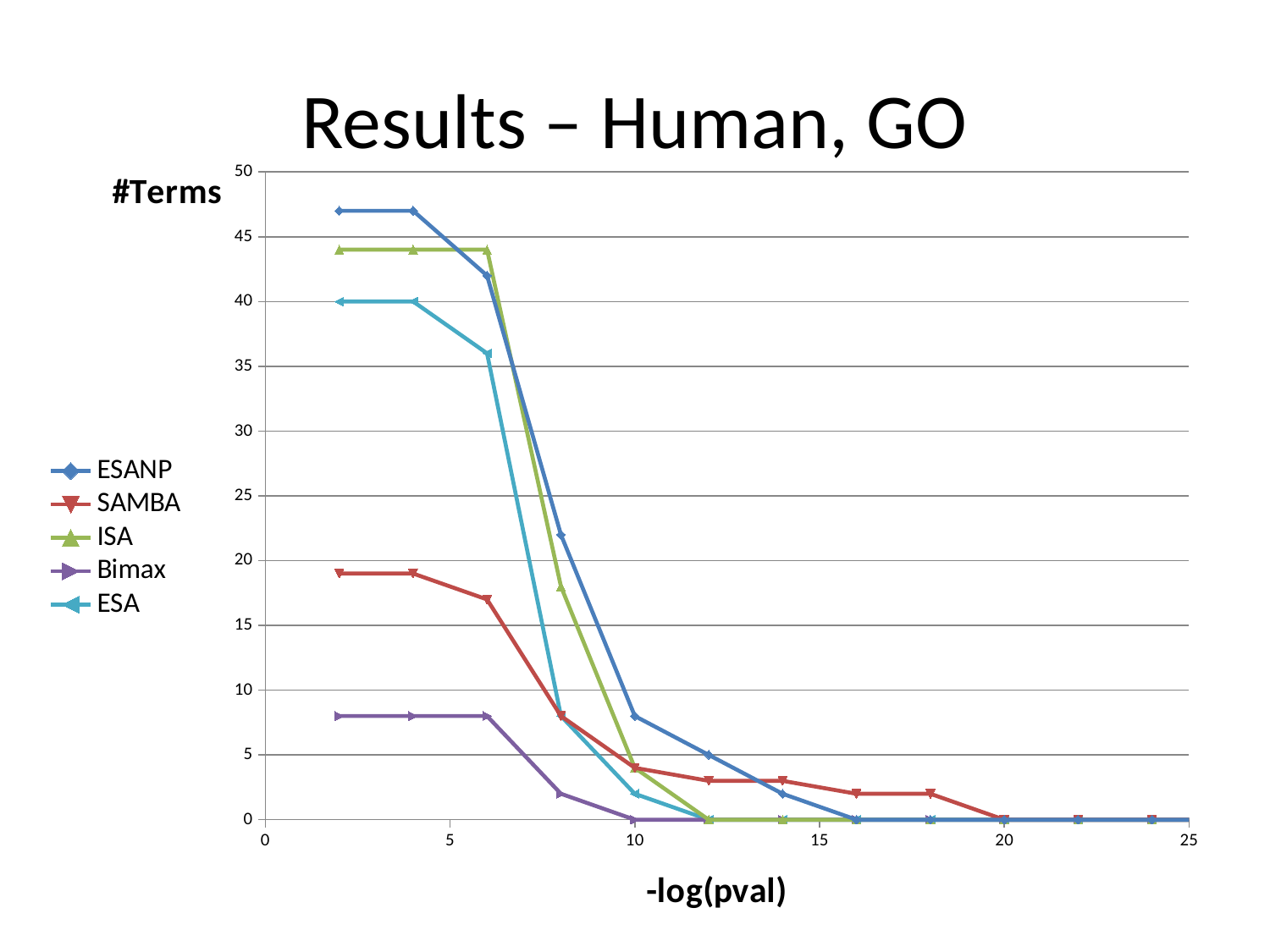
Is the #Terms value for SAMBA at -log(pval) = 2 greater or less than 20? less Do the #Terms values for ESANP rise or fall as -log(pval) increases? fall Is the #Terms value for ESANP at -log(pval) = 2 greater or less than 45? greater What is the #Terms value for ESA at -log(pval) = 2? 40 At -log(pval) = 2, which series has the larger #Terms value, ISA or ESA? ISA How many series does the legend list? 5 Which series has the lowest #Terms at -log(pval) = 2? Bimax What kind of chart is shown on the slide? line chart Which series has the highest #Terms at -log(pval) = 2? ESANP What is the #Terms value for Bimax at -log(pval) = 10? 0 What is the label of the x axis? -log(pval) What is the #Terms value for ESANP at -log(pval) = 12? 5